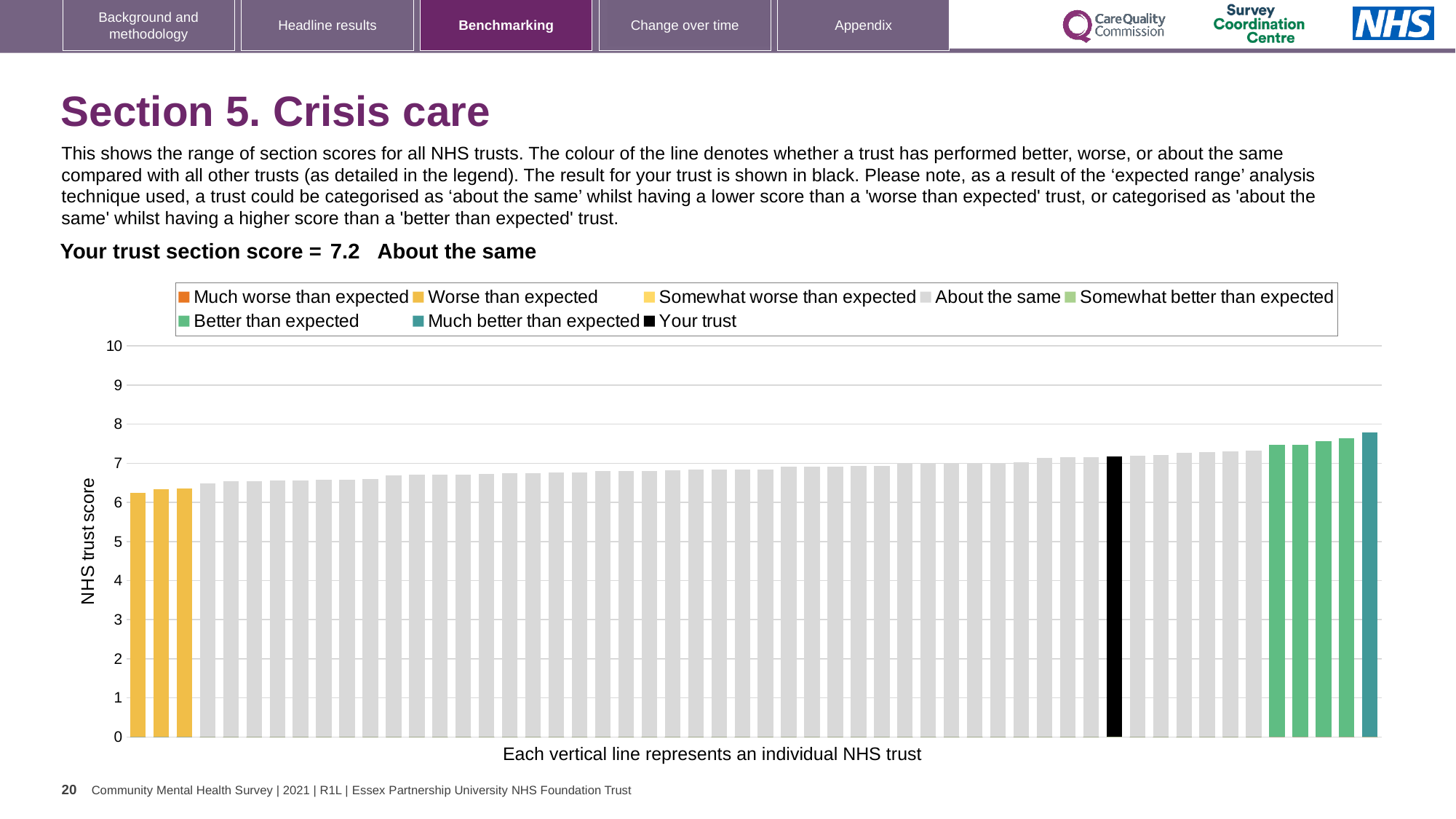
Which category is your trust's section score placed in? About the same What is the section score for your trust shown on the slide? 7.2 Do the bar values rise or fall from left to right along the x axis? Rise How many bars are coloured as 'Worse than expected' (yellow)? 3 Is the value of the rightmost (highest) bar greater or less than 7? greater Is the value of the leftmost (lowest) bar greater or less than 7? less How many bars are coloured as 'Much worse than expected' (orange)? 0 What kind of chart is shown on the slide? Bar chart How many entries does the chart legend list? 8 What is the label on the vertical axis of the chart? NHS trust score Which legend category does the tallest bar belong to? Much better than expected Is the value of the black 'Your trust' bar greater or less than 5? greater